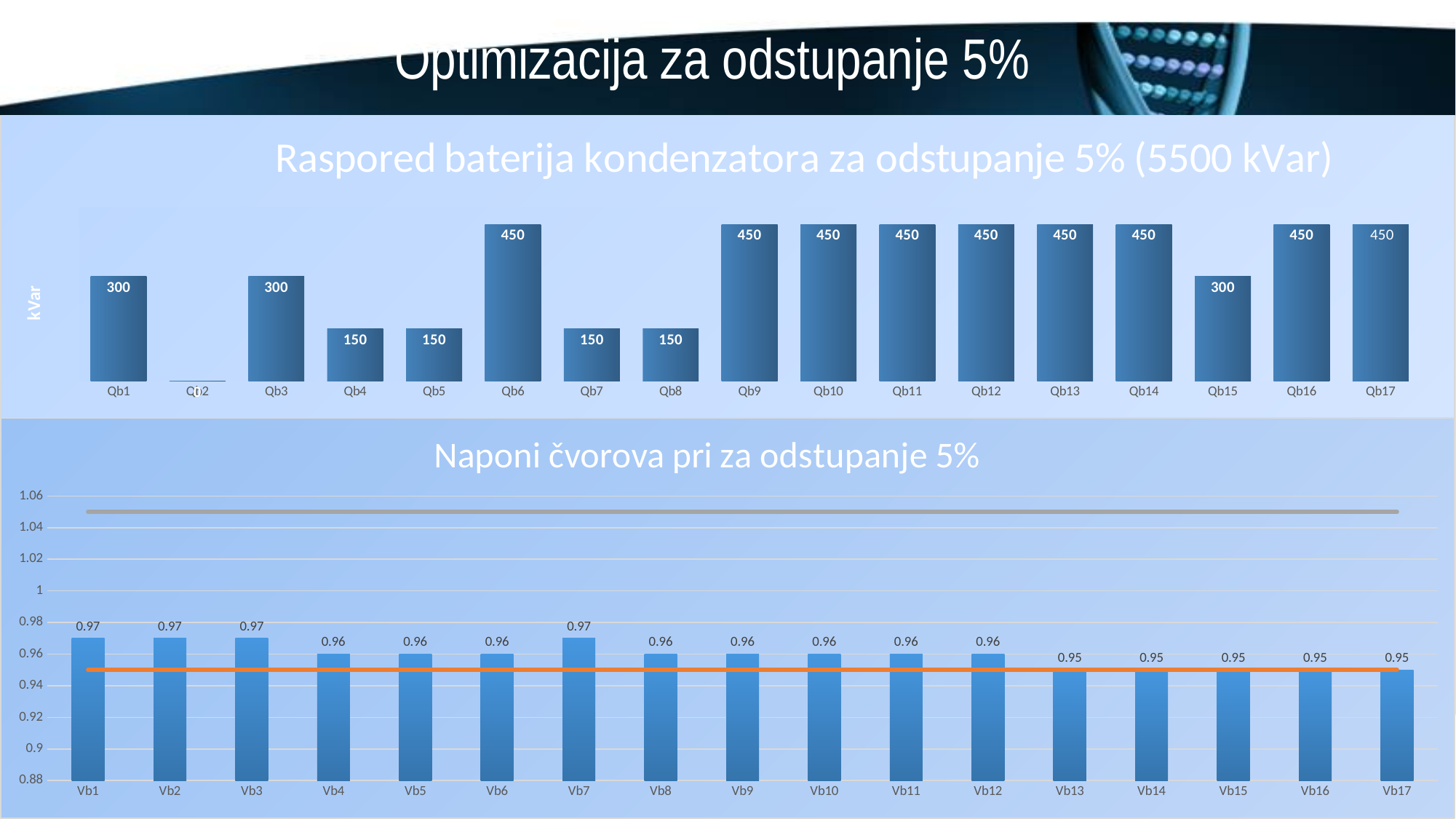
In the top chart 'Raspored baterija kondenzatora za odstupanje 5% (5500 kVar)', what is the value for Qb6? 450 In the top chart 'Raspored baterija kondenzatora za odstupanje 5% (5500 kVar)', which category has the lowest value? Qb2 In the bottom chart 'Naponi čvorova pri za odstupanje 5%', what is the value for Vb13? 0.95 In the top chart 'Raspored baterija kondenzatora za odstupanje 5% (5500 kVar)', which is larger, the value for Qb1 or the value for Qb5? Qb1 In the bottom chart 'Naponi čvorova pri za odstupanje 5%', what is the value for Vb7? 0.97 In the top chart 'Raspored baterija kondenzatora za odstupanje 5% (5500 kVar)', what is the value for Qb15? 300 In the bottom chart 'Naponi čvorova pri za odstupanje 5%', what is the difference between the values for Vb1 and Vb17? 0.02 In the top chart 'Raspored baterija kondenzatora za odstupanje 5% (5500 kVar)', how many categories are shown on the x axis? 17 In the top chart 'Raspored baterija kondenzatora za odstupanje 5% (5500 kVar)', what is the difference between the values for Qb9 and Qb7? 300 In the top chart 'Raspored baterija kondenzatora za odstupanje 5% (5500 kVar)', what is the value for Qb4? 150 What kind of chart is the bottom chart 'Naponi čvorova pri za odstupanje 5%'? combination bar and line chart In the bottom chart 'Naponi čvorova pri za odstupanje 5%', do the bar values generally rise or fall from Vb1 to Vb17? fall